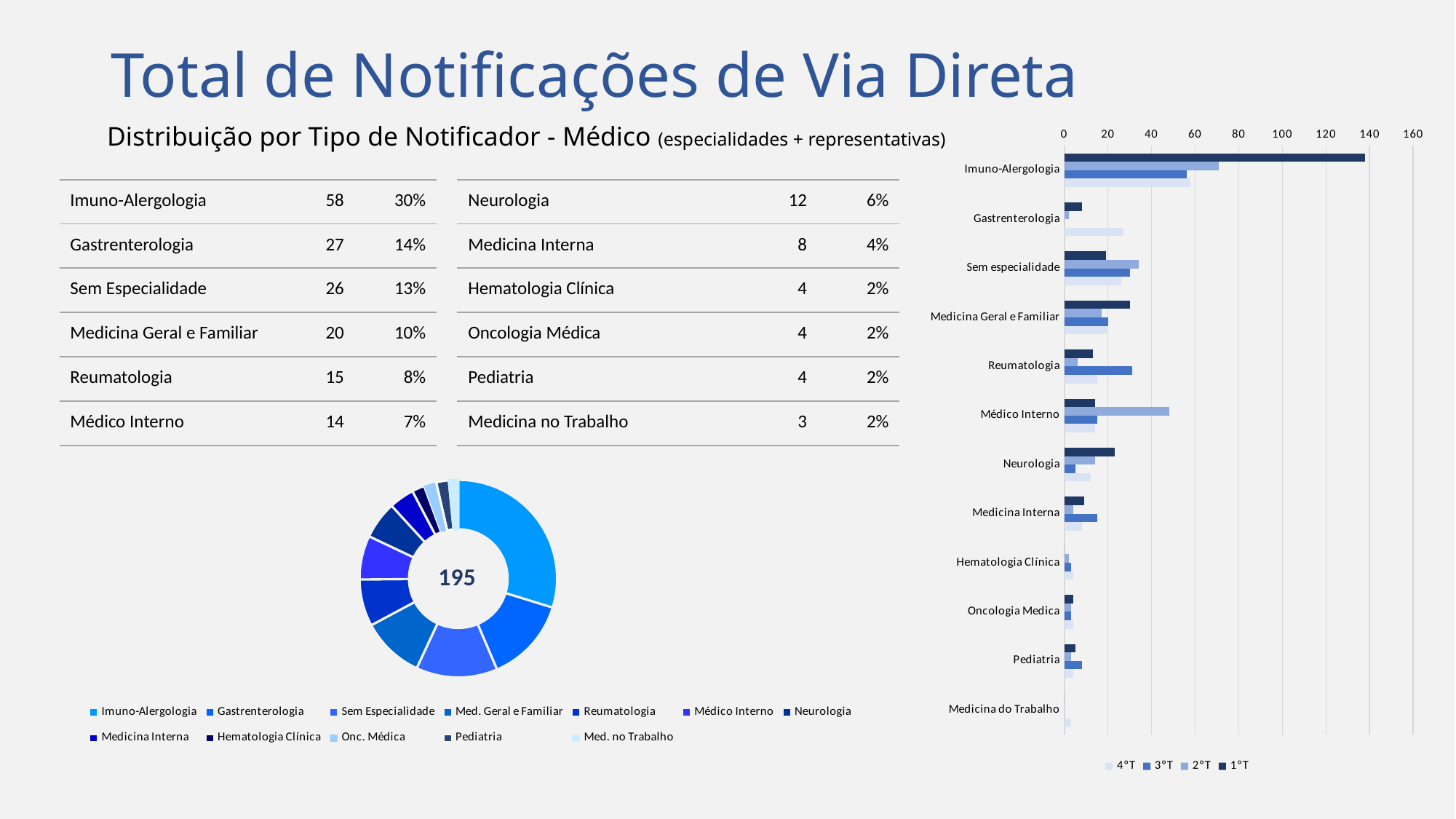
What is the highest value shown on the horizontal axis of the bar chart on the right? 160 In the bar chart on the right, which is larger for Neurologia: the 1°T bar or the 4°T bar? 1°T What kind of chart is the chart at the bottom left of the slide? donut chart In the bar chart on the right, is the 1°T value for Imuno-Alergologia greater or less than 120? greater In the bar chart on the right, is the 2°T value for Médico Interno greater or less than 40? greater In the bar chart on the right, which category has the longest bar? Imuno-Alergologia How many series does the legend of the bar chart on the right list? 4 In the bar chart on the right, is the 1°T value for Medicina Interna greater or less than 20? less What kind of chart is the chart on the right side of the slide? bar chart How many categories are shown on the bar chart on the right? 12 How many entries does the legend of the donut chart list? 12 What number is shown in the centre of the donut chart? 195